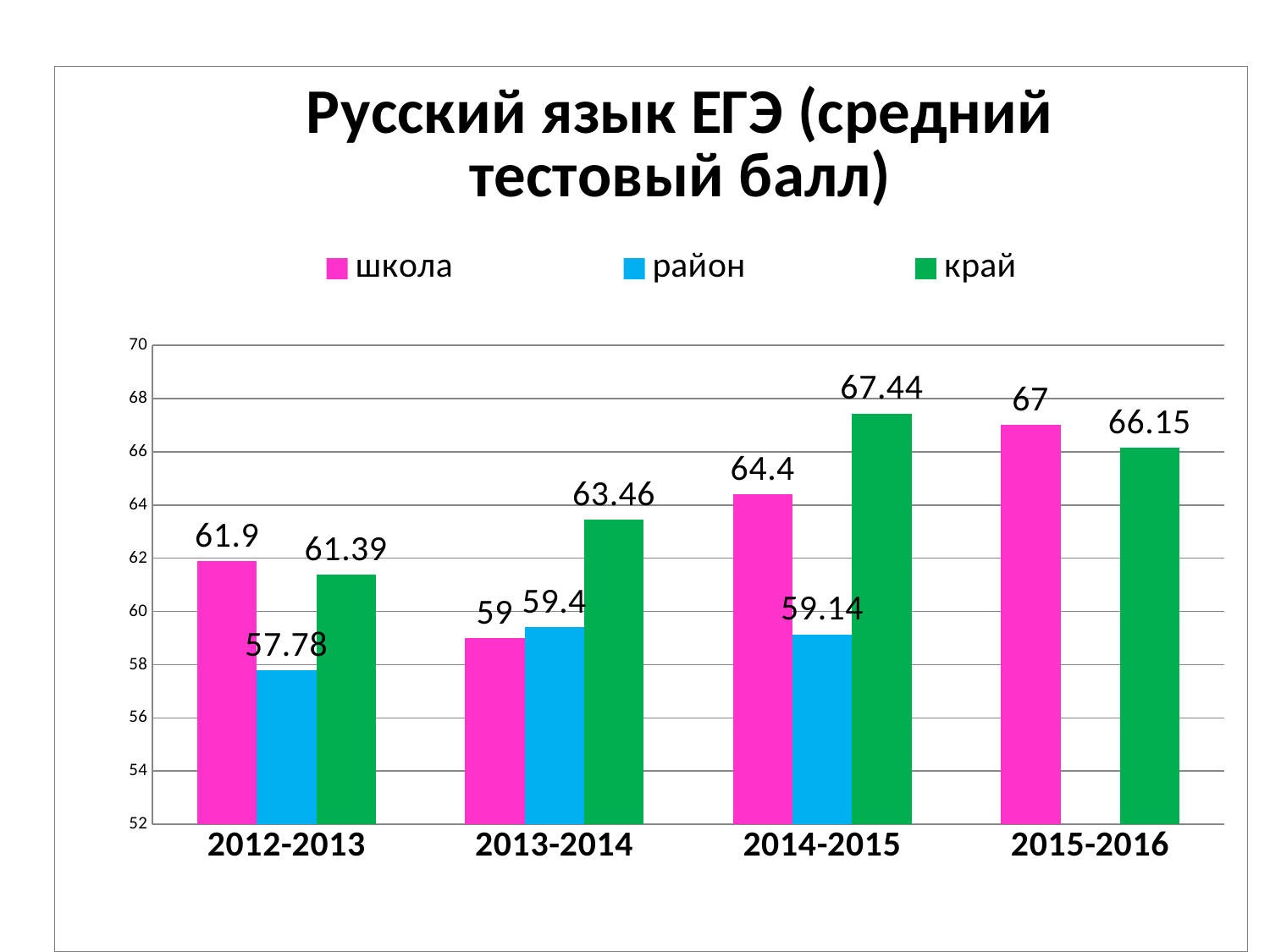
Which is larger in 2015-2016, школа or край? школа Do the values for школа rise or fall from 2013-2014 to 2015-2016? rise Is the value for школа in 2014-2015 greater or less than 64? greater What is the value for школа in 2012-2013? 61.9 What is the difference between край and школа in 2013-2014? 4.46 How many year categories are shown on the x axis? 4 What is the value for район in 2014-2015? 59.14 In which year does район have its lowest value? 2012-2013 How many series does the legend list? 3 What kind of chart is this? bar chart In which year does край have its highest value? 2014-2015 What is the value for край in 2015-2016? 66.15